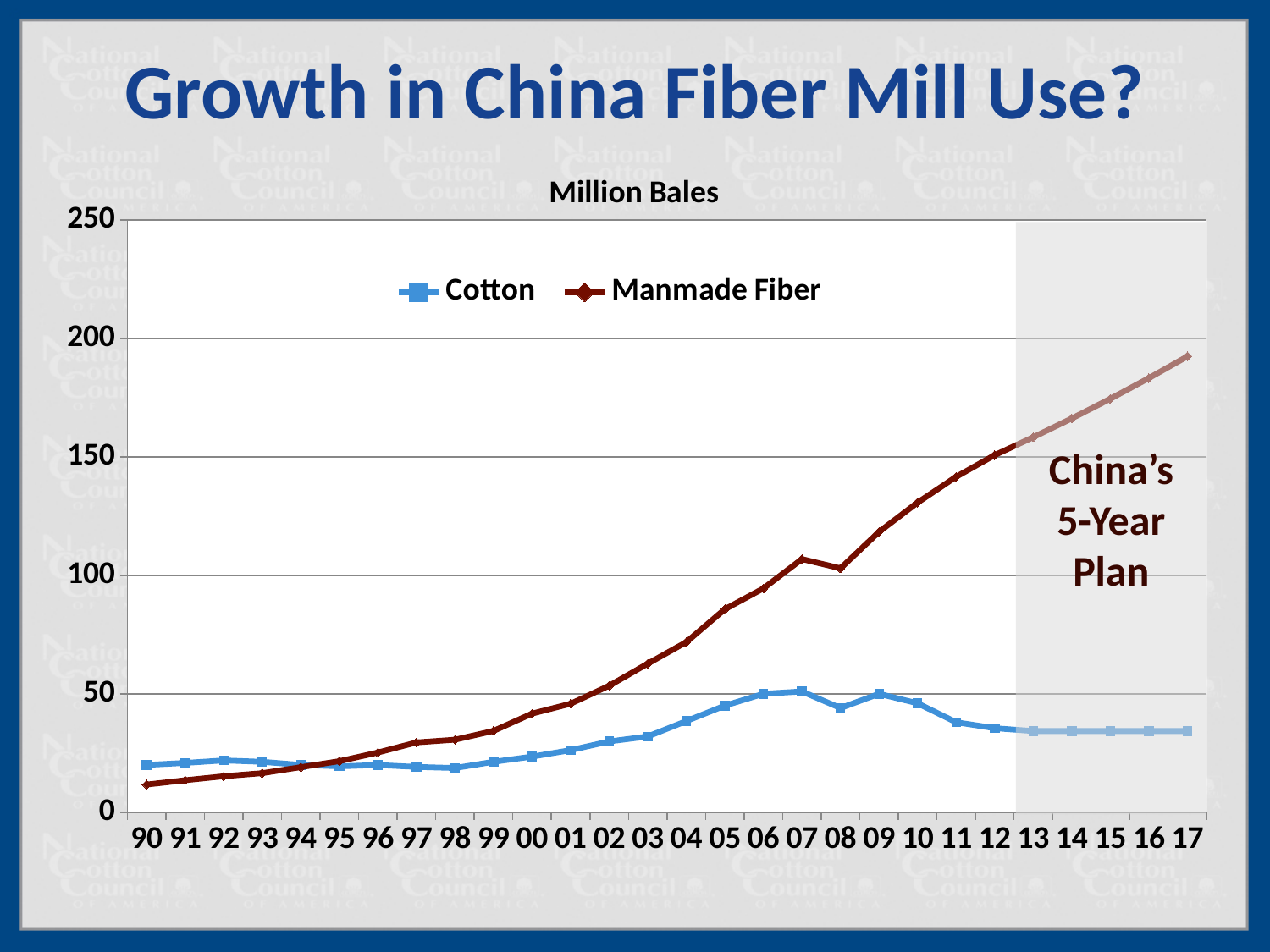
Which series has the larger value in 90, Cotton or Manmade Fiber? Cotton Is the value for Manmade Fiber in 90 greater or less than 50? less How many series does the legend list? 2 Is the value for Manmade Fiber in 10 greater or less than 100? greater Is the value for Cotton in 17 greater or less than 50? less Do the Manmade Fiber values generally rise or fall from 90 to 17? rise Which series has the larger value in 17, Cotton or Manmade Fiber? Manmade Fiber How many years are plotted along the x axis? 28 What unit is given in the label above the chart? Million Bales What kind of chart is shown on the slide? line chart In which year does Manmade Fiber reach its highest value? 17